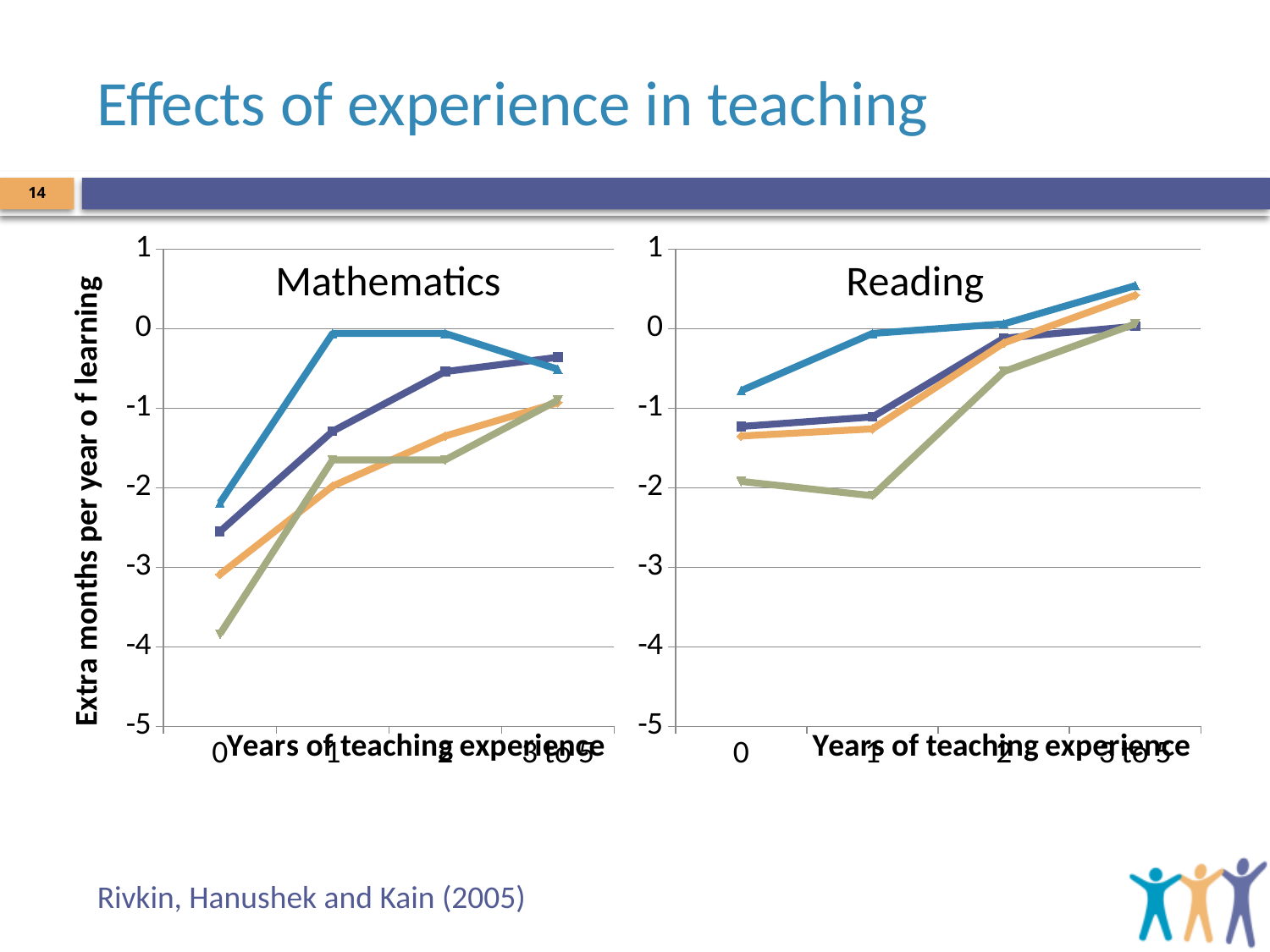
In the Mathematics chart, is the value of the blue line at 0 years of experience greater or less than -2? less How many years-of-experience categories are shown on the x axis of the Reading chart? 4 In the Reading chart, do the lines generally rise or fall as years of teaching experience increase? rise In the Mathematics chart, at 0 years of experience, which line is higher: the blue line or the green line? the blue line In the Mathematics chart, which line has the lowest value at 0 years of experience? the green line How many lines are plotted in the Mathematics chart? 4 What is the x-axis label of the Reading chart? Years of teaching experience What is the y-axis label shared by the two charts? Extra months per year of learning In the Mathematics chart, is the value of the green line at 0 years of experience greater or less than -3? less In the Reading chart, is the value of the green line at 1 year of experience greater or less than -1? less What kind of chart is the Mathematics chart? line chart